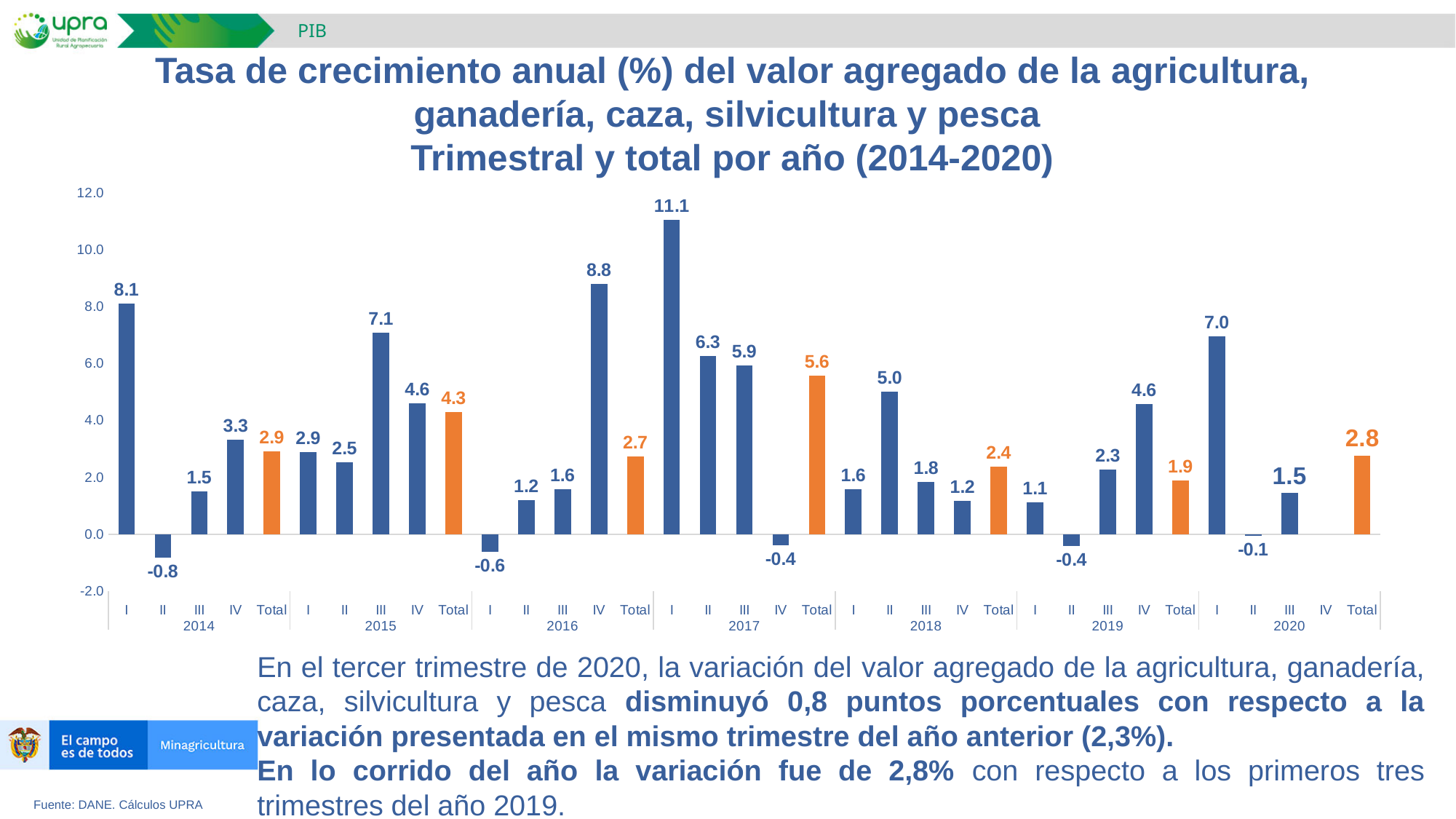
What is the Total value shown for 2020? 2.8 Which quarter or total has the highest growth rate in the chart? I 2017 What is the difference between the Total for 2017 and the Total for 2018? 3.2 Do the quarterly values for 2017 rise or fall from quarter I to quarter IV? Fall Which quarter or total has the lowest growth rate in the chart? II 2014 Which is larger: the value for quarter IV of 2016 or quarter III of 2015? IV 2016 How many years are shown on the x axis of the chart? 7 What kind of chart is shown on the slide? Bar chart What colour are the bars for the annual Total values? Orange What is the annual growth rate for quarter I of 2017? 11.1 What is the Total value for 2019? 1.9 What is the difference between the Total for 2015 and the Total for 2014? 1.4